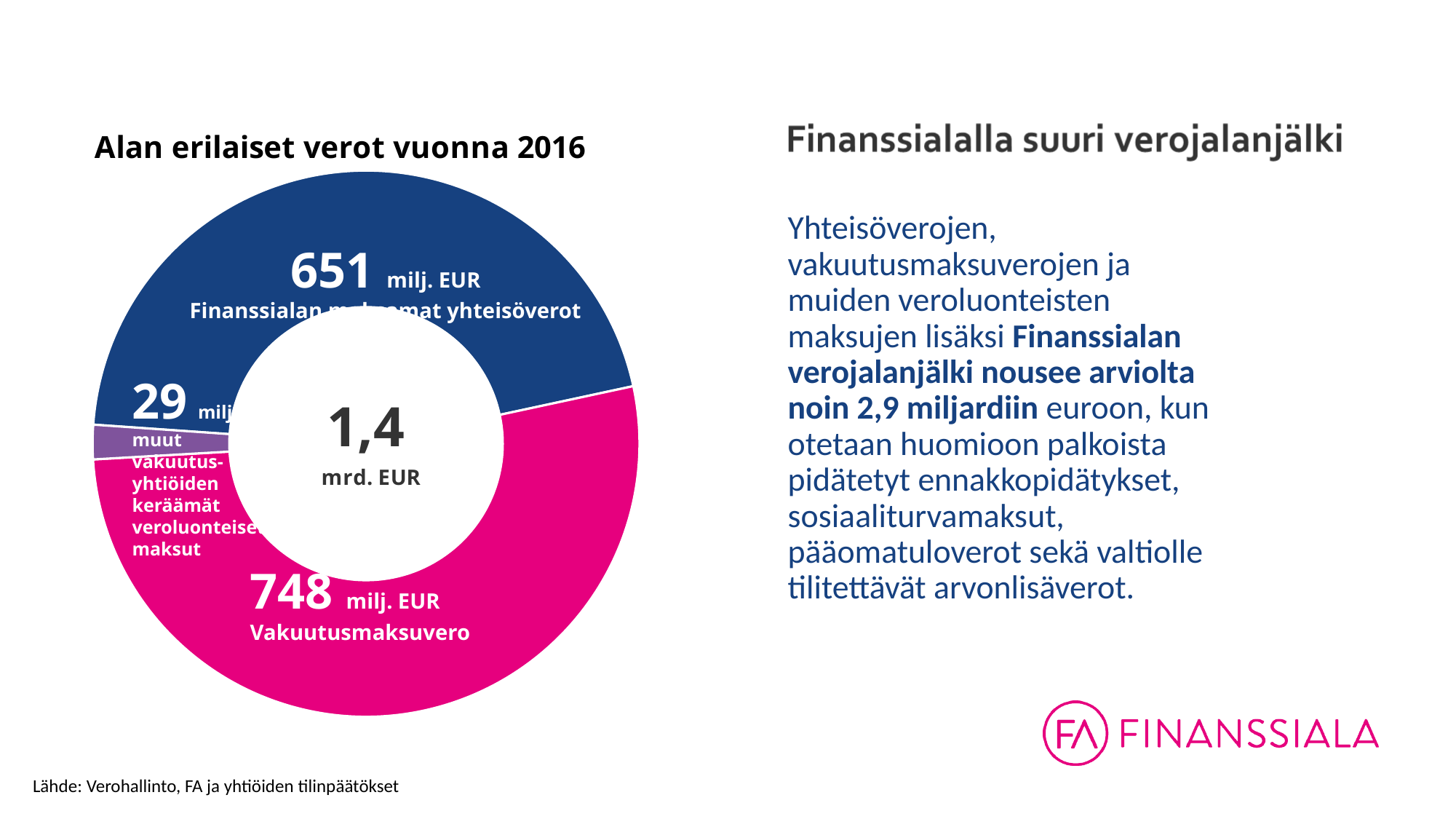
How many slices does the donut chart have? 3 Which category has the smallest value in the chart? muut vakuutusyhtiöiden keräämät veroluonteiset maksut Which category has the largest value in the chart? Vakuutusmaksuvero What is the title of the chart? Alan erilaiset verot vuonna 2016 What is the difference between Vakuutusmaksuvero and Finanssialan maksamat yhteisöverot? 97 milj. EUR What colour is the Vakuutusmaksuvero slice? Pink (magenta) Which is larger, Finanssialan maksamat yhteisöverot or Vakuutusmaksuvero? Vakuutusmaksuvero What value is shown for muut vakuutusyhtiöiden keräämät veroluonteiset maksut? 29 milj. EUR How much are the Finanssialan maksamat yhteisöverot according to the chart? 651 milj. EUR What total is printed in the centre of the donut chart? 1,4 mrd. EUR What is the value of the Vakuutusmaksuvero slice in the donut chart? 748 milj. EUR What kind of chart is shown on the slide? Donut (pie) chart